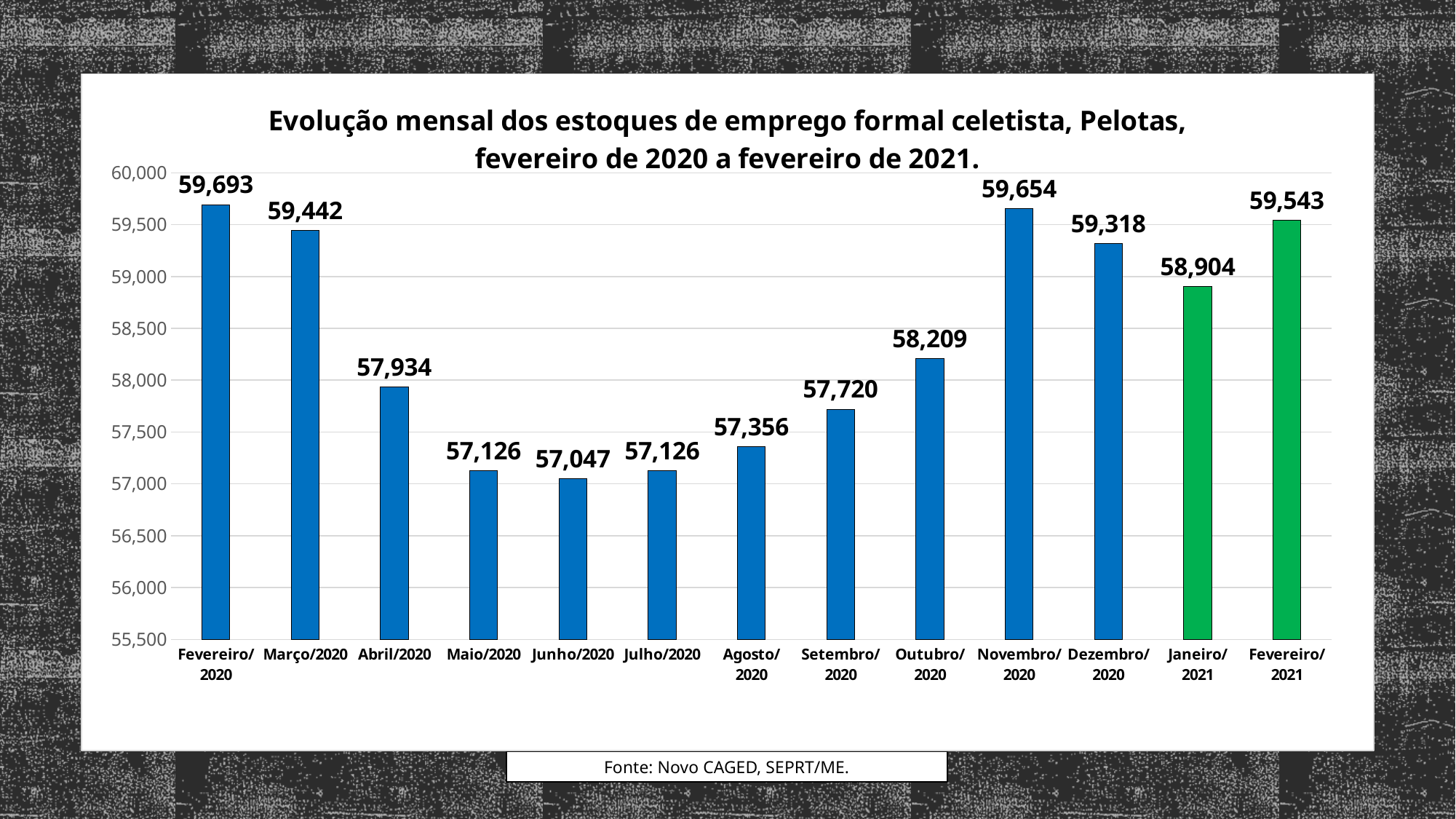
What is the value for Outubro/2020? 58,209 What is the difference between the values for Fevereiro/2020 and Fevereiro/2021? 150 What is the value for Abril/2020? 57,934 What is the value for Fevereiro/2021? 59,543 How many months are shown on the chart? 13 What kind of chart is shown on the slide? bar chart What is the difference between the values for Novembro/2020 and Outubro/2020? 1,445 Is the value for Abril/2020 greater or less than 58,000? less Which month has the highest value? Fevereiro/2020 Which is larger, the value for Dezembro/2020 or the value for Janeiro/2021? Dezembro/2020 Which month has the lowest value? Junho/2020 Do the values rise or fall from Junho/2020 to Novembro/2020? rise